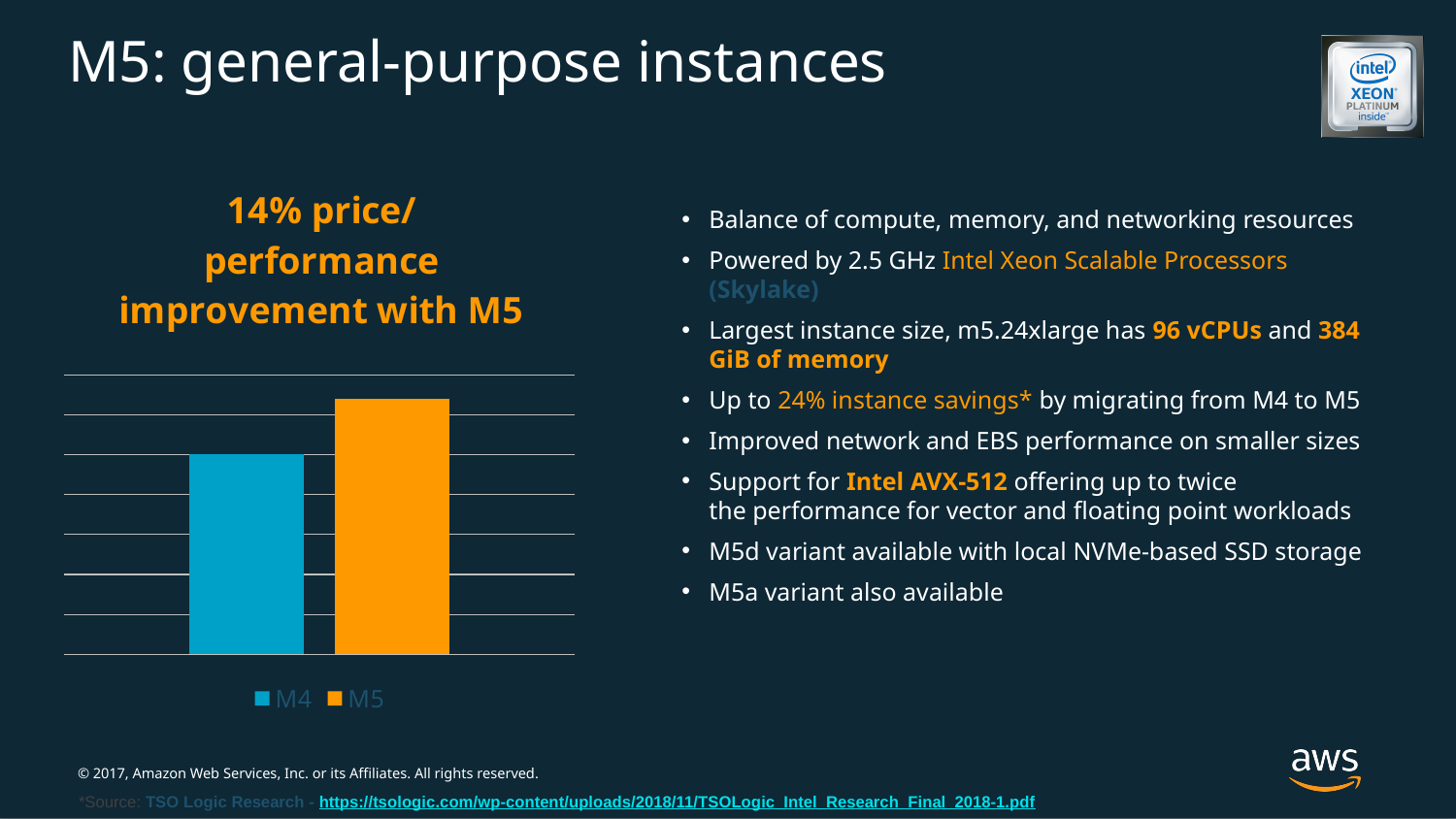
Which series has the lowest bar in the chart? M4 What kind of chart is shown on the slide? bar chart What are the two entries listed in the chart legend? M4 and M5 How many bars are plotted in the chart? 2 Which bar is taller in the chart, M4 or M5? M5 How many series does the chart legend list? 2 Which series has the highest bar in the chart? M5 What colour is the M5 bar in the chart? orange